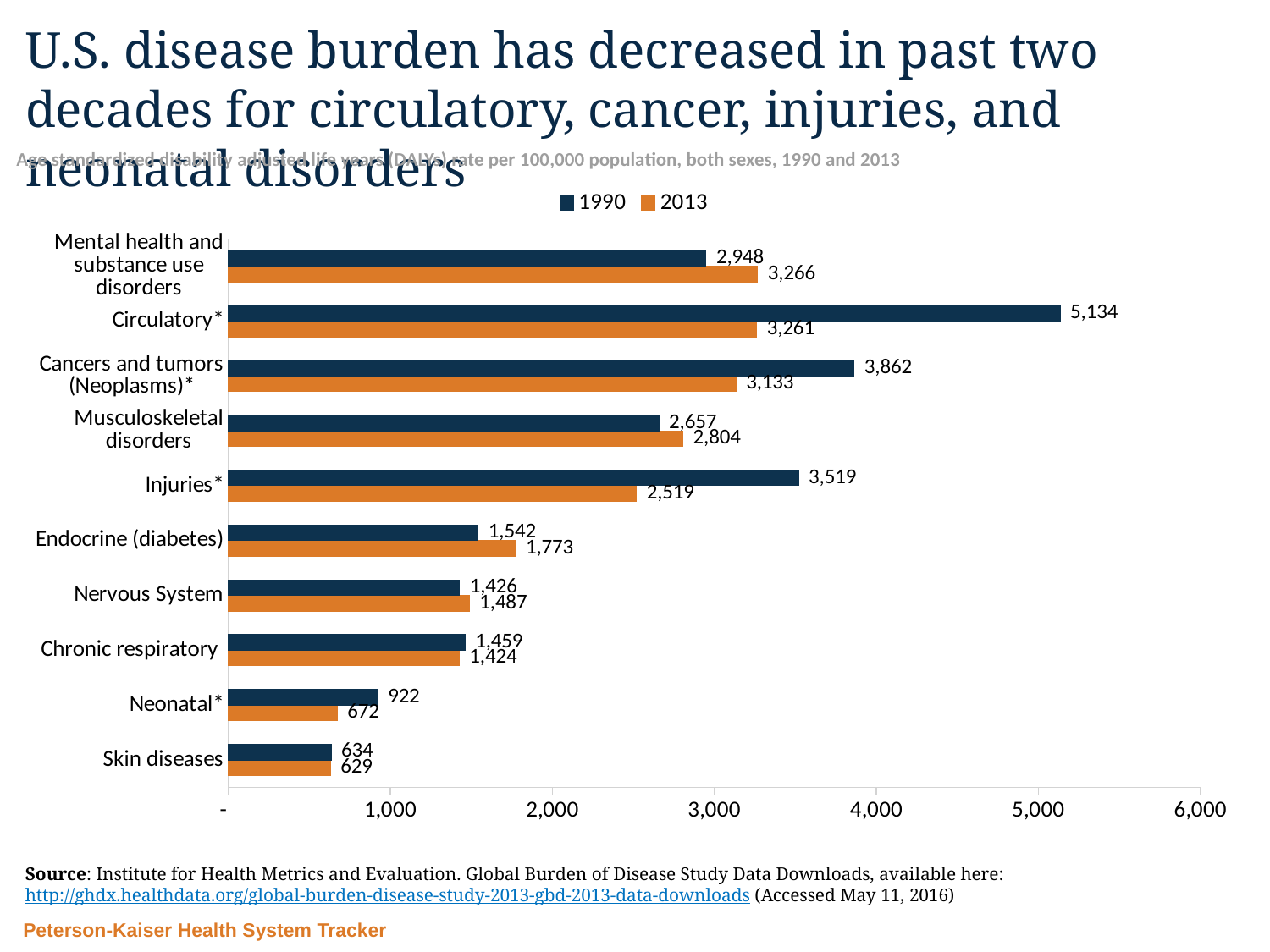
What is the 1990 value for Circulatory*? 5,134 How many categories are shown on the chart? 10 Which is larger for Endocrine (diabetes): the 1990 value or the 2013 value? 2013 What kind of chart is shown on the slide? Bar chart What is the difference between the 1990 and 2013 values for Neonatal*? 250 Is the 1990 value for Cancers and tumors (Neoplasms)* greater or less than 3,000? greater What is the 2013 value for Mental health and substance use disorders? 3,266 Which category has the lowest 2013 value? Skin diseases Which category has the highest 1990 value? Circulatory* What is the 2013 value for Injuries*? 2,519 What is the difference between the 1990 and 2013 values for Circulatory*? 1,873 How many series does the legend list? 2